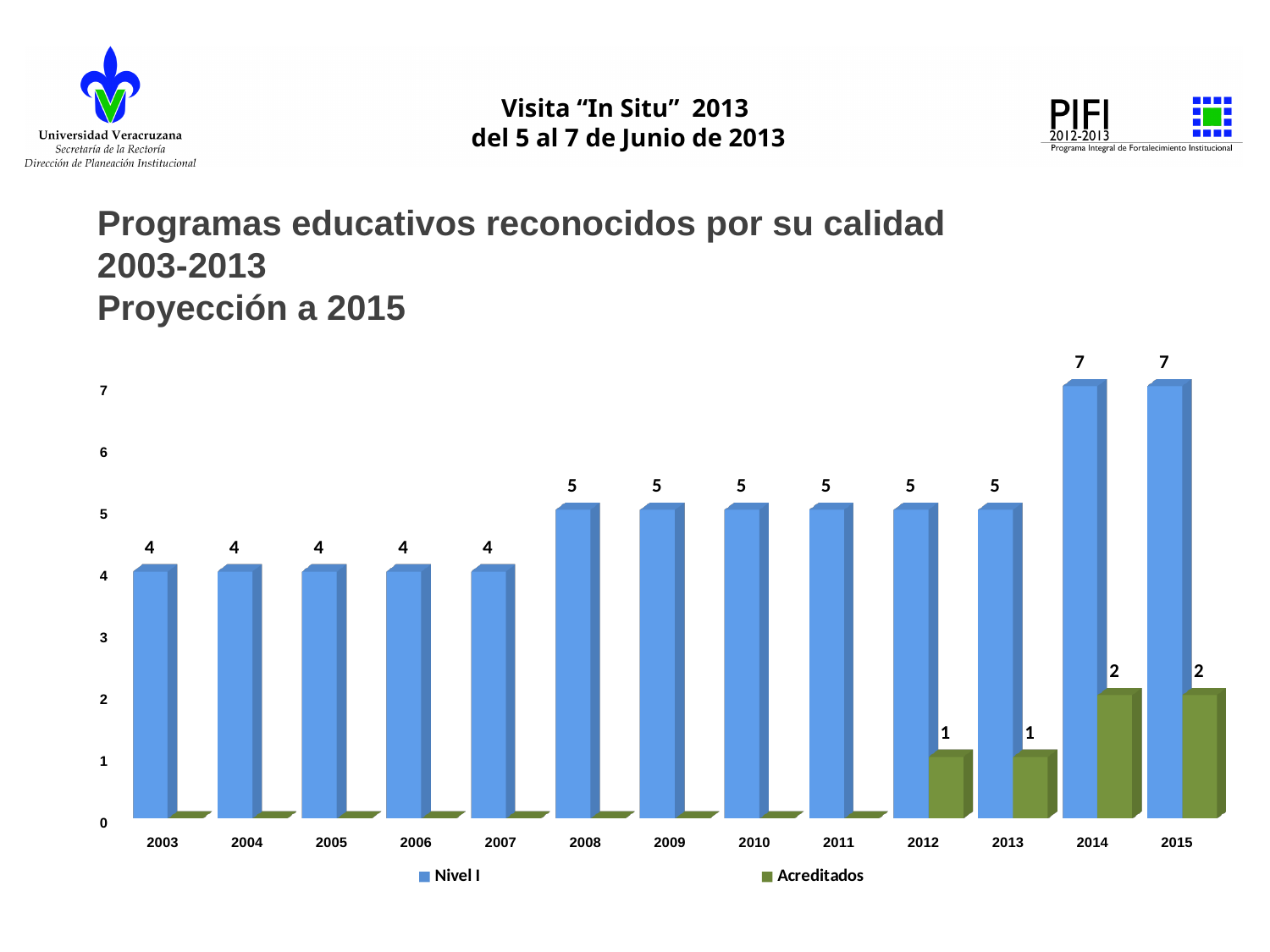
What is the Nivel I value for 2008? 5 What is the Nivel I value for 2003? 4 Do the Nivel I values rise or fall from 2003 to 2015? Rise How many years are shown on the x axis? 13 What colour are the Acreditados bars? Green What is the Acreditados value for 2014? 2 Which year has the highest Nivel I value? 2014 and 2015 What is the Acreditados value for 2012? 1 What kind of chart is shown on the slide? Bar chart How many series does the legend list? 2 Which is larger, the Nivel I value for 2007 or the Nivel I value for 2008? 2008 What is the difference between the Nivel I value for 2014 and the Nivel I value for 2013? 2